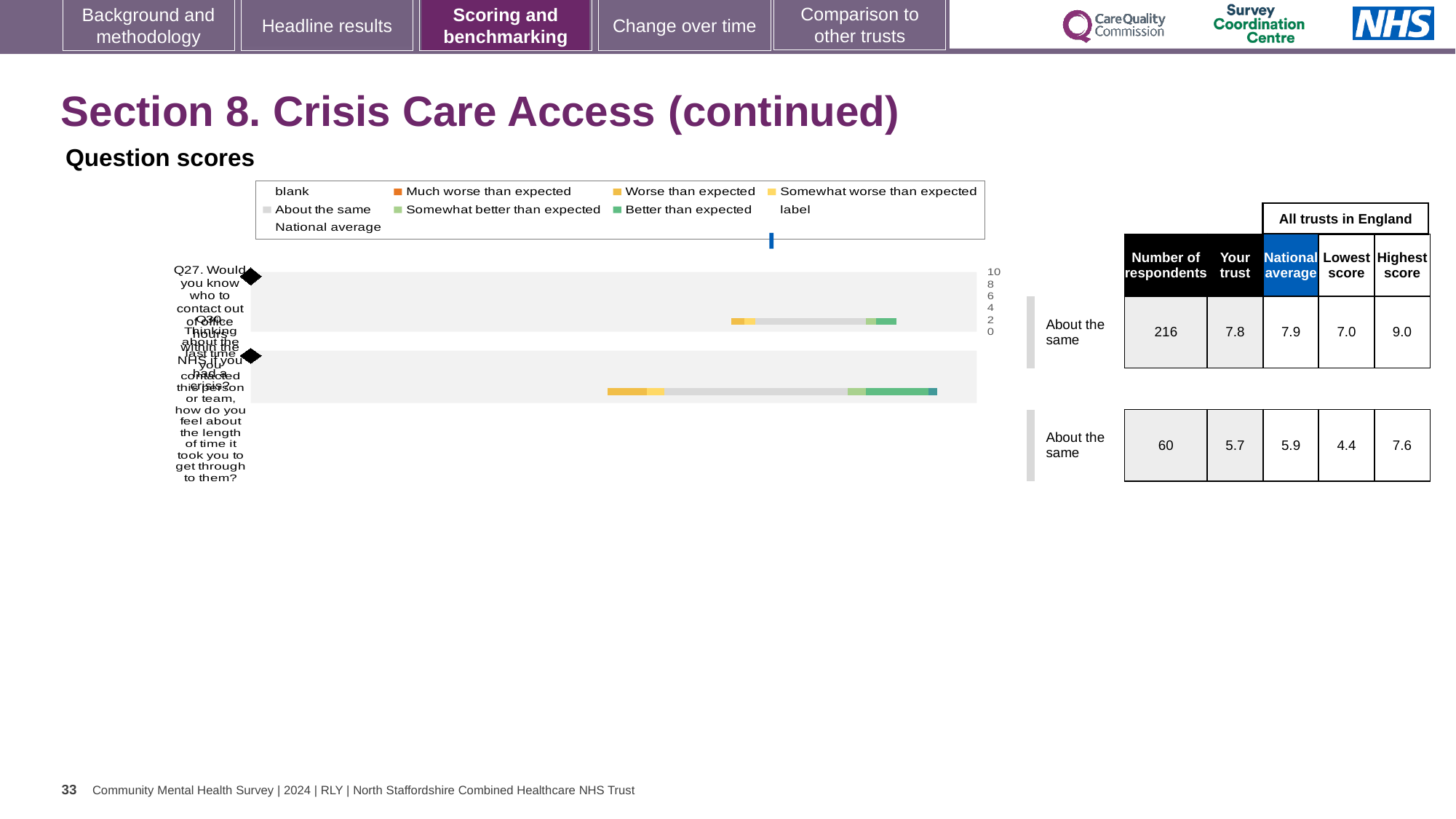
What is the lowest score among all trusts in England for the first (top) question row? 7.0 Is the 'Your trust' score for the bottom question row greater or less than the national average for that row? less How many questions (rows) are plotted in the chart? 2 What kind of chart is shown under 'Question scores'? bar chart How many respondents answered the second (bottom) question? 60 What is the difference between the highest and lowest scores for the second (bottom) question row? 3.2 What is the 'Your trust' score for the first (top) question row? 7.8 What is the maximum value shown on the chart's score axis? 10 What is the highest score among all trusts in England for the second (bottom) question row? 7.6 Which question row has the higher 'Your trust' score, the top row or the bottom row? the top row What benchmark category is shown for both question rows? About the same What is the national average for the first (top) question row? 7.9